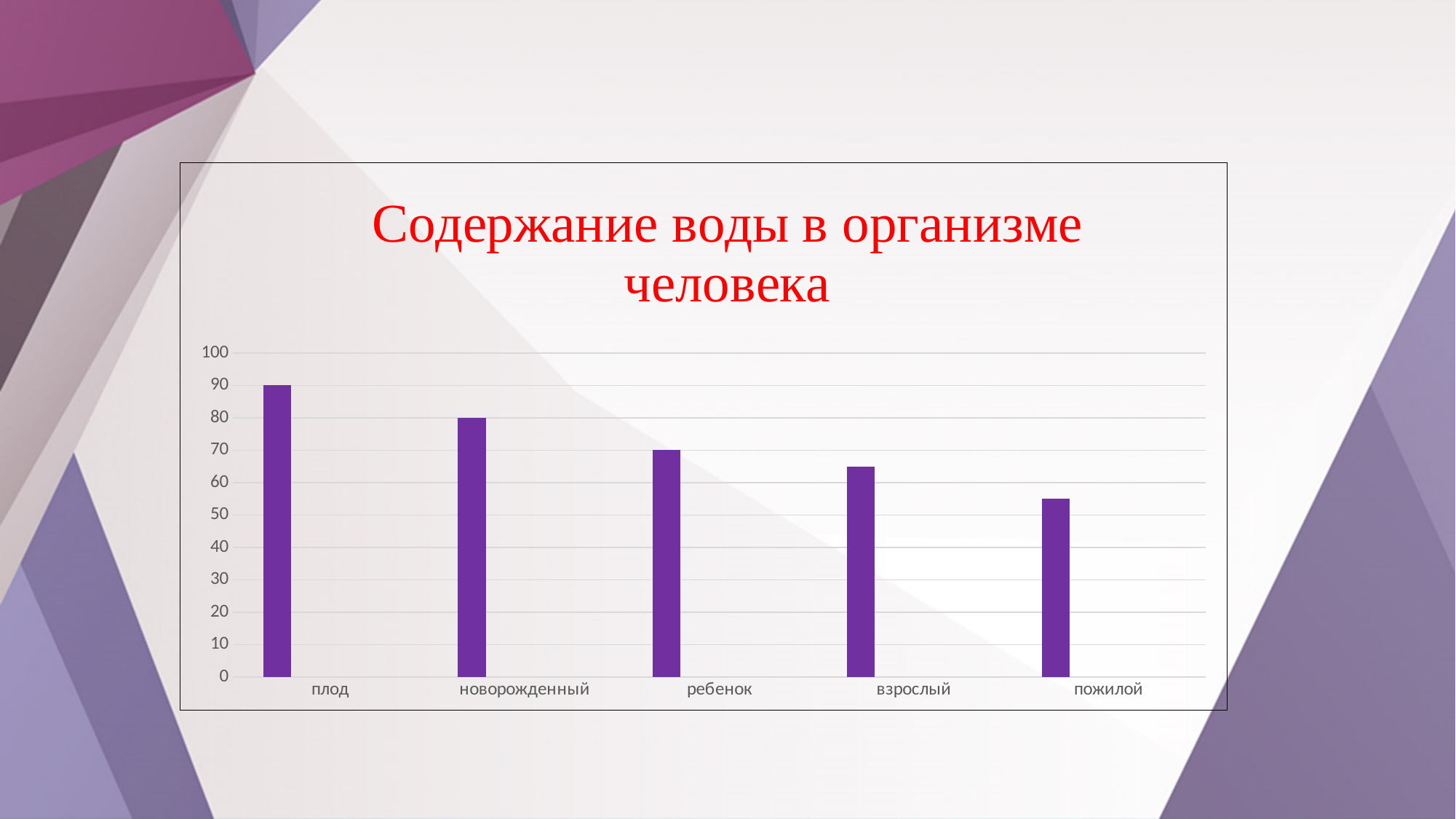
Which is larger, the value for новорожденный or the value for взрослый? новорожденный What is the value for ребенок? 70 Do the values rise or fall from left to right along the x axis? fall How many categories are shown on the x axis? 5 What is the difference between the values for плод and ребенок? 20 Which category has the highest value? плод Is the value for пожилой greater or less than 60? less What is the value for новорожденный? 80 What is the value for плод? 90 Which category has the lowest value? пожилой What kind of chart is this? bar chart Is the value for взрослый greater or less than 60? greater